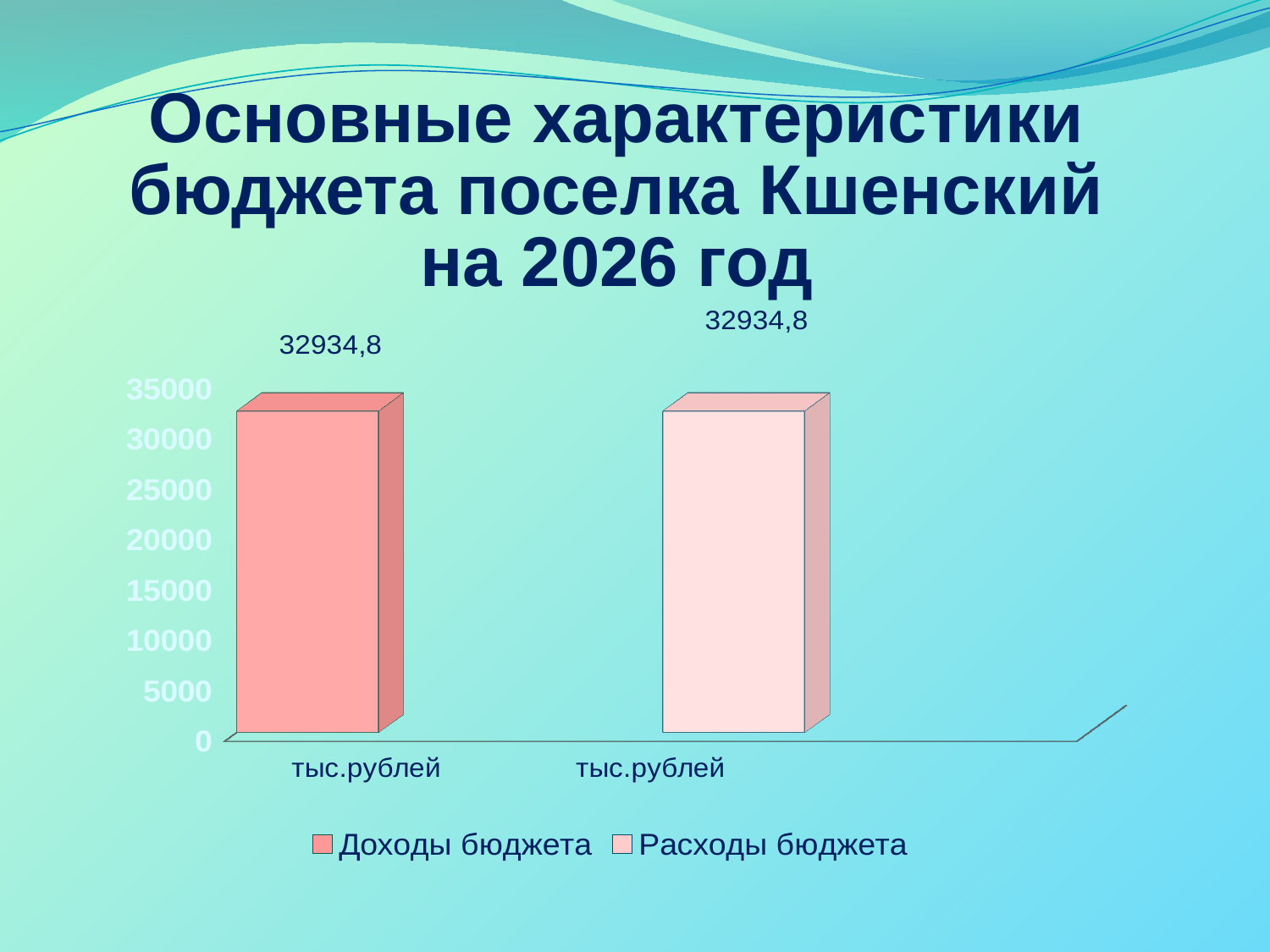
What is the highest value shown on the vertical axis? 35000 Is the value for Доходы бюджета greater or less than 30000? greater What unit label appears under each bar on the horizontal axis? тыс.рублей How many bars are plotted on the chart? 2 What kind of chart is shown on the slide? Bar chart How many series does the legend list? 2 What is the value of the Доходы бюджета bar? 32934,8 What is the value of the Расходы бюджета bar? 32934,8 What is the difference between the Доходы бюджета value and the Расходы бюджета value? 0 Is the value for Расходы бюджета greater or less than 35000? less What is the title of the slide containing the chart? Основные характеристики бюджета поселка Кшенский на 2026 год